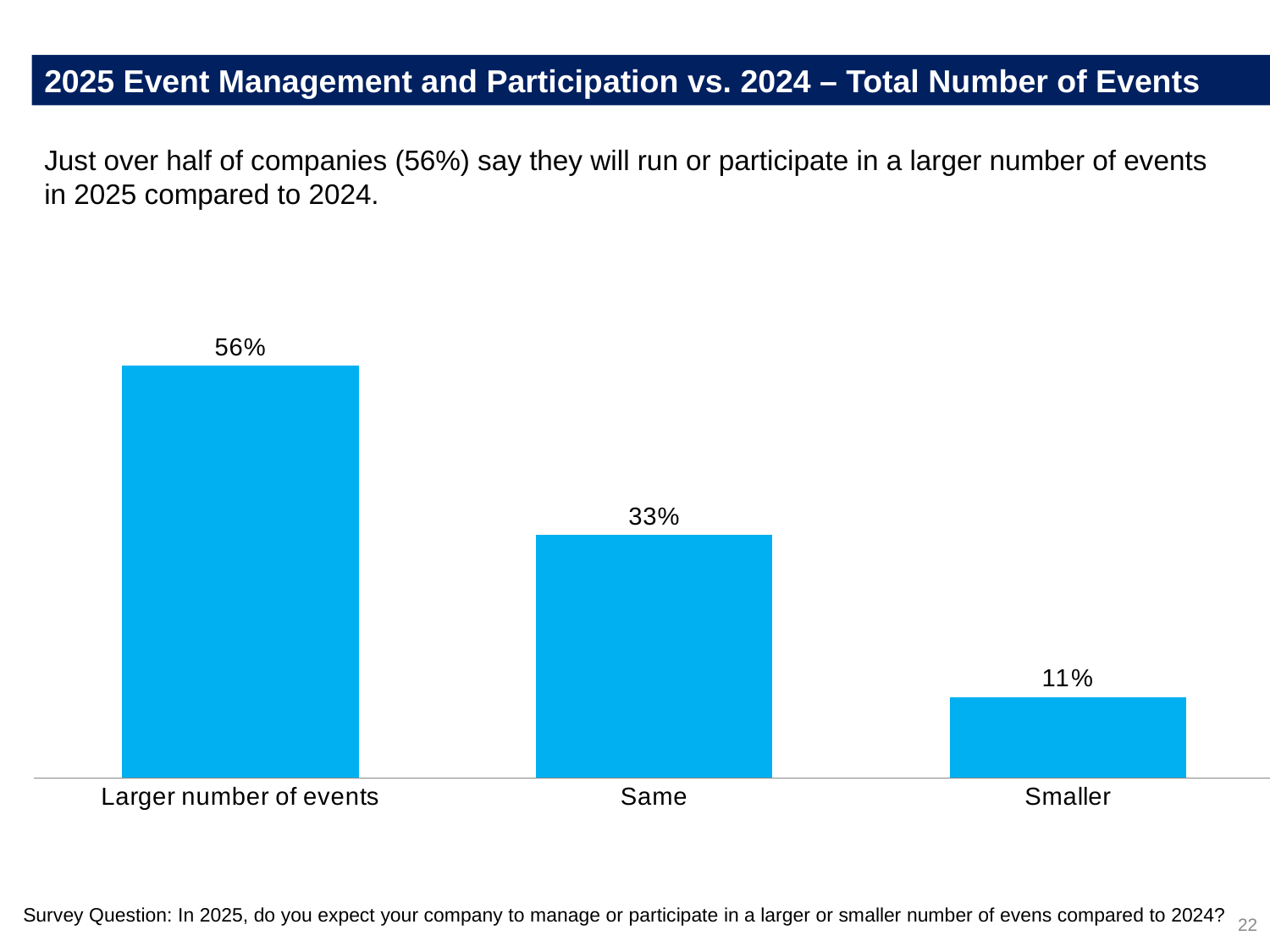
Which category has the highest value? Larger number of events What is the value for the 'Same' category? 33% Which is larger, the value for 'Same' or the value for 'Smaller'? Same What is the difference between the 'Larger number of events' and 'Same' values? 23% What kind of chart is shown on the slide? Bar chart What is the total of the three values shown in the chart? 100% What is the difference between the 'Same' and 'Smaller' values? 22% Do the values rise or fall from left to right across the categories? Fall Which category has the lowest value? Smaller How many categories are shown in the chart? 3 What percentage of companies say they will run or participate in a larger number of events? 56% What is the value for the 'Smaller' category? 11%